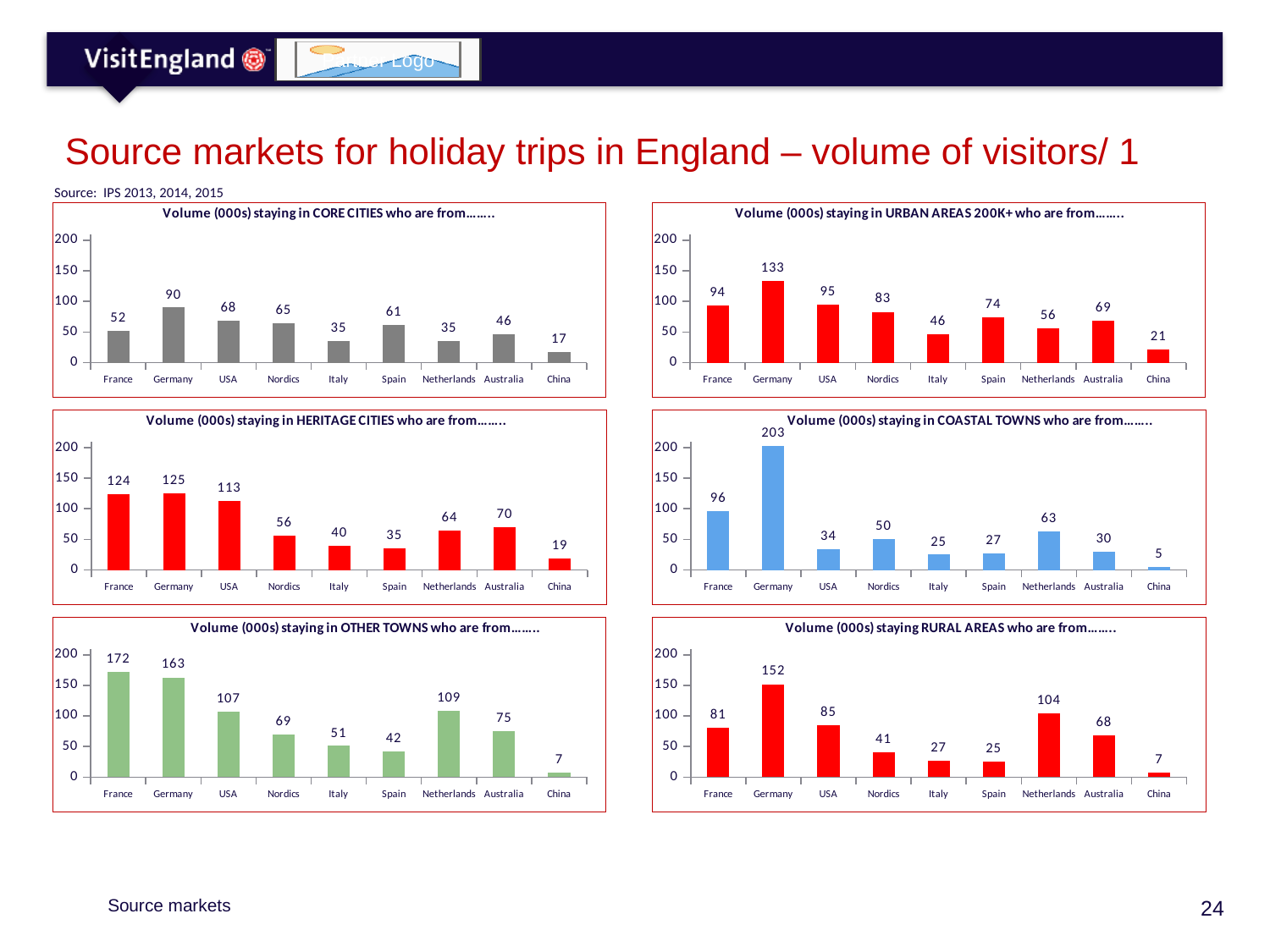
In the 'Volume (000s) staying in URBAN AREAS 200K+' chart, which country has the highest value? Germany In the 'Volume (000s) staying in COASTAL TOWNS' chart, what is the difference between the values for Germany and France? 107 In the 'Volume (000s) staying in HERITAGE CITIES' chart, which country has the lowest value? China In the 'Volume (000s) staying in HERITAGE CITIES' chart, what is the value for the USA? 113 In the 'Volume (000s) staying in OTHER TOWNS' chart, which is larger, the value for France or the value for Germany? France In the 'Volume (000s) staying in CORE CITIES' chart, what is the value for Germany? 90 What kind of chart is the 'Volume (000s) staying in COASTAL TOWNS' chart? bar chart In the 'Volume (000s) staying in OTHER TOWNS' chart, what is the value for China? 7 How many countries are shown on the x axis of the 'Volume (000s) staying in CORE CITIES' chart? 9 In the 'Volume (000s) staying RURAL AREAS' chart, is the value for Germany greater or less than 100? greater In the 'Volume (000s) staying in URBAN AREAS 200K+' chart, what is the difference between the values for Germany and Italy? 87 How many charts are shown on the slide? 6